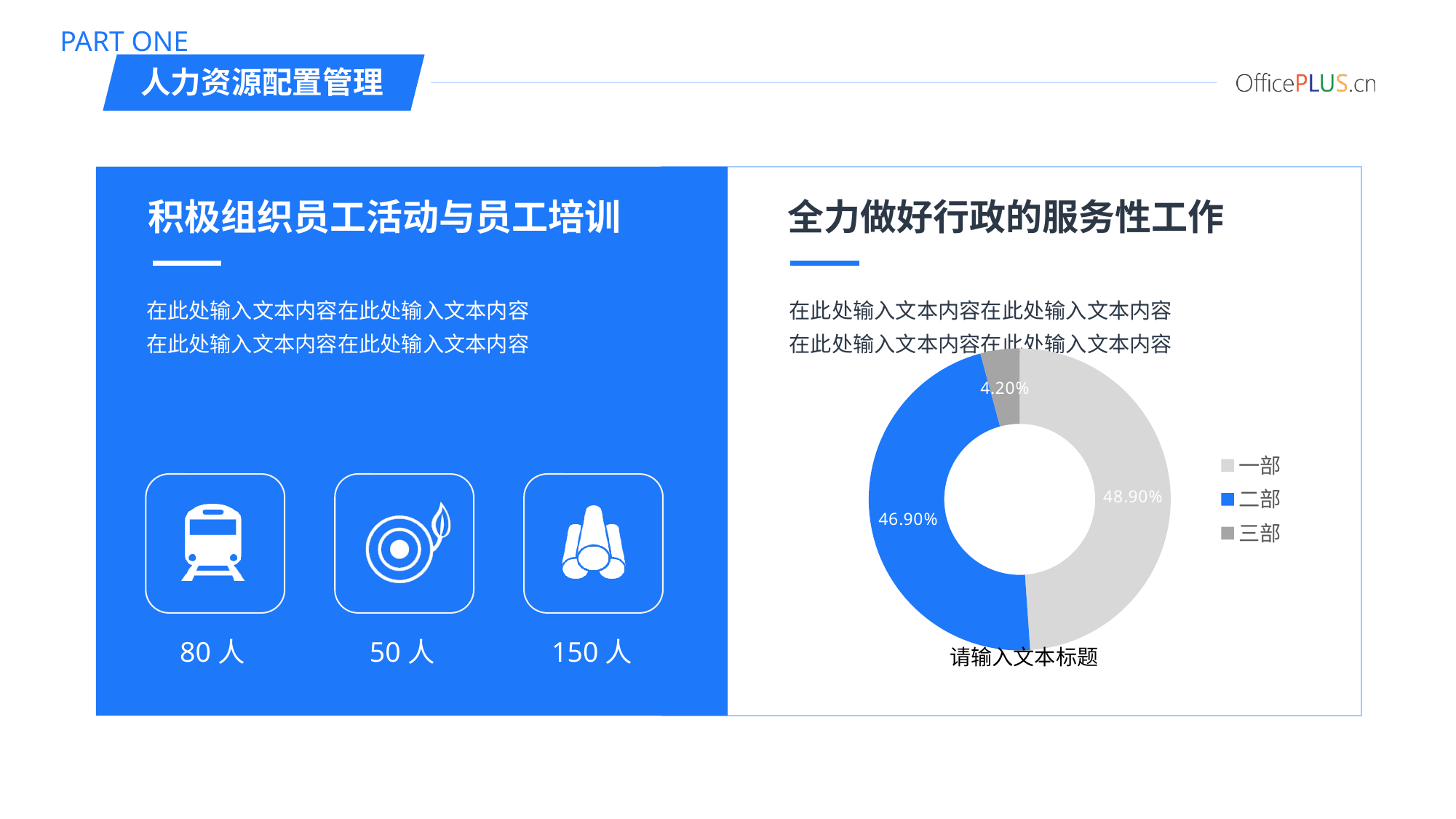
How many entries does the chart legend list? 3 What percentage does the 一部 slice show? 48.90% What kind of chart is shown on the slide? doughnut chart What is the difference between the 一部 and 二部 percentages? 2.00% Which category has the largest share of the doughnut chart? 一部 What percentage does the 三部 slice show? 4.20% How many slices does the doughnut chart have? 3 What colour is the 二部 slice in the doughnut chart? blue Which category has the smallest share of the doughnut chart? 三部 What percentage does the 二部 slice show? 46.90% What is the difference between the 一部 and 三部 percentages? 44.70% Which is larger, the share for 一部 or the share for 二部? 一部